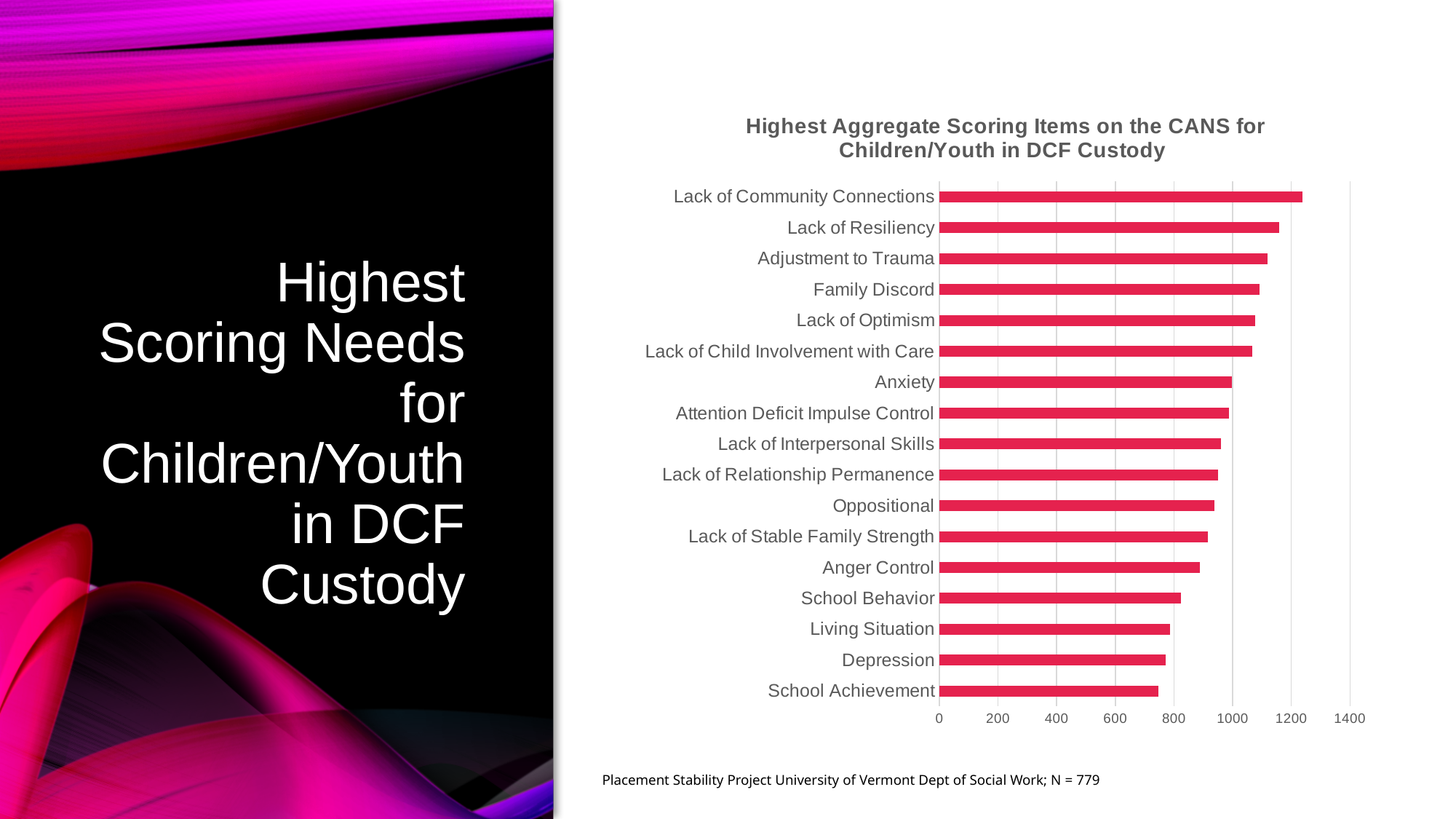
Is the value for Anger Control greater or less than 1000? less Is the value for Family Discord greater or less than 1000? greater What is the title of the chart? Highest Aggregate Scoring Items on the CANS for Children/Youth in DCF Custody Is the value for School Achievement greater or less than 800? less Which item has the highest value in the chart? Lack of Community Connections Which has a larger value, Depression or Adjustment to Trauma? Adjustment to Trauma What kind of chart is shown on the slide? bar chart Which item has the lowest value in the chart? School Achievement Which has a larger value, Lack of Resiliency or Anger Control? Lack of Resiliency How many items are plotted in the chart? 17